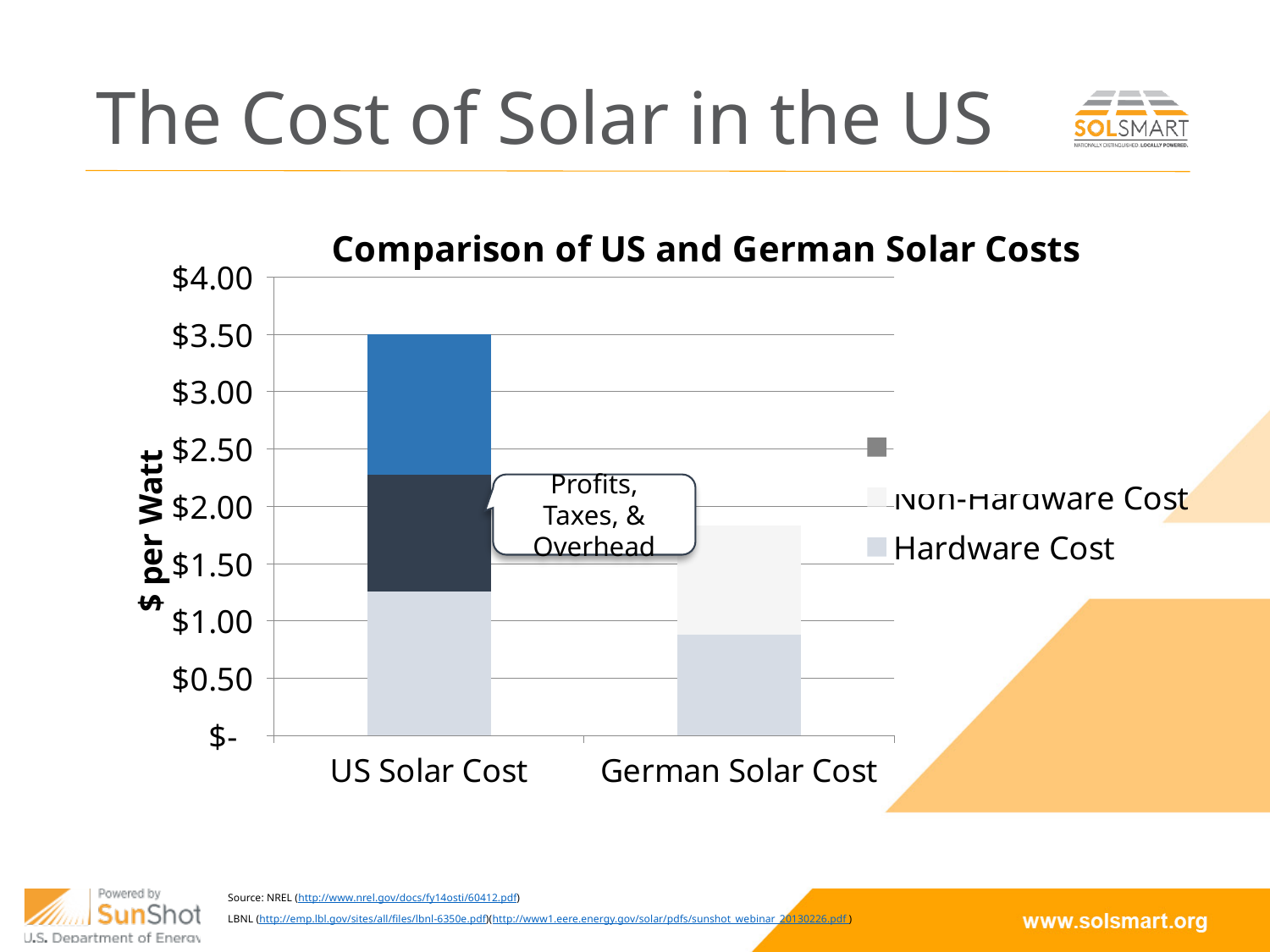
Is the Hardware Cost for German Solar Cost greater or less than $1.00? less What kind of chart is shown on the slide? Stacked bar chart What is the title of the chart? Comparison of US and German Solar Costs What is the total height of the US Solar Cost bar? $3.50 Which category has the lower total solar cost? German Solar Cost What is the label on the y axis of the chart? $ per Watt Is the Hardware Cost for US Solar Cost greater or less than $1.00? greater Is the total for German Solar Cost greater or less than $2.00? less Which category has the higher total solar cost? US Solar Cost How many categories are shown on the x axis of the chart? 2 Is the total for US Solar Cost larger or smaller than the total for German Solar Cost? larger